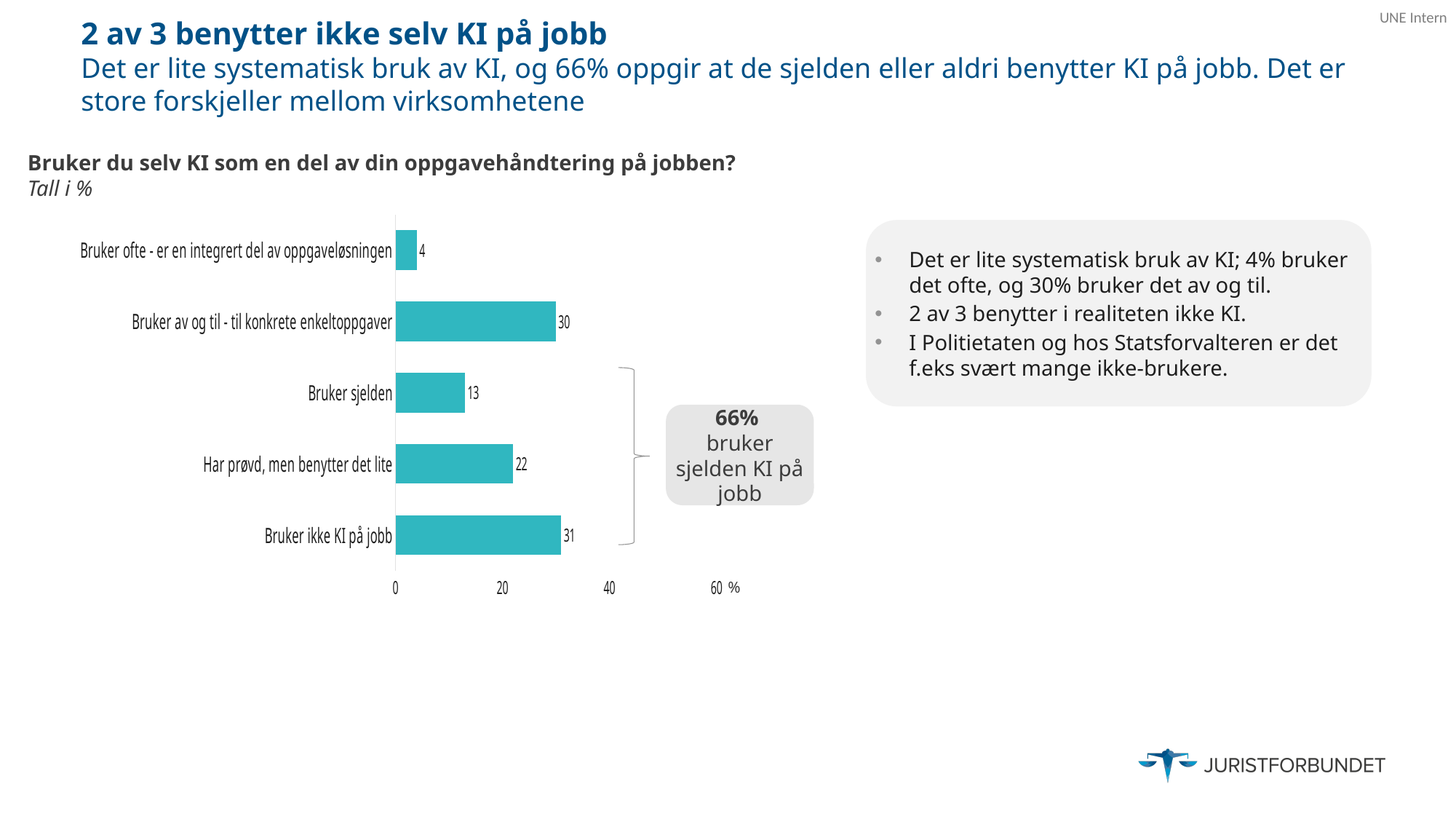
What is the difference between the values for "Bruker ikke KI på jobb" and "Bruker sjelden"? 18 What is the value for "Bruker ofte - er en integrert del av oppgaveløsningen"? 4 What is the value for "Bruker av og til - til konkrete enkeltoppgaver"? 30 What kind of chart is shown on the slide? Bar chart Which category has the highest value? Bruker ikke KI på jobb What question is the chart titled with? Bruker du selv KI som en del av din oppgavehåndtering på jobben? Is the value for "Bruker av og til - til konkrete enkeltoppgaver" greater or less than 20? greater How many categories are shown in the chart? 5 Which is larger: the value for "Har prøvd, men benytter det lite" or the value for "Bruker sjelden"? Har prøvd, men benytter det lite Which category has the lowest value? Bruker ofte - er en integrert del av oppgaveløsningen What is the total of the values for "Bruker sjelden", "Har prøvd, men benytter det lite" and "Bruker ikke KI på jobb"? 66 What is the value for "Har prøvd, men benytter det lite"? 22